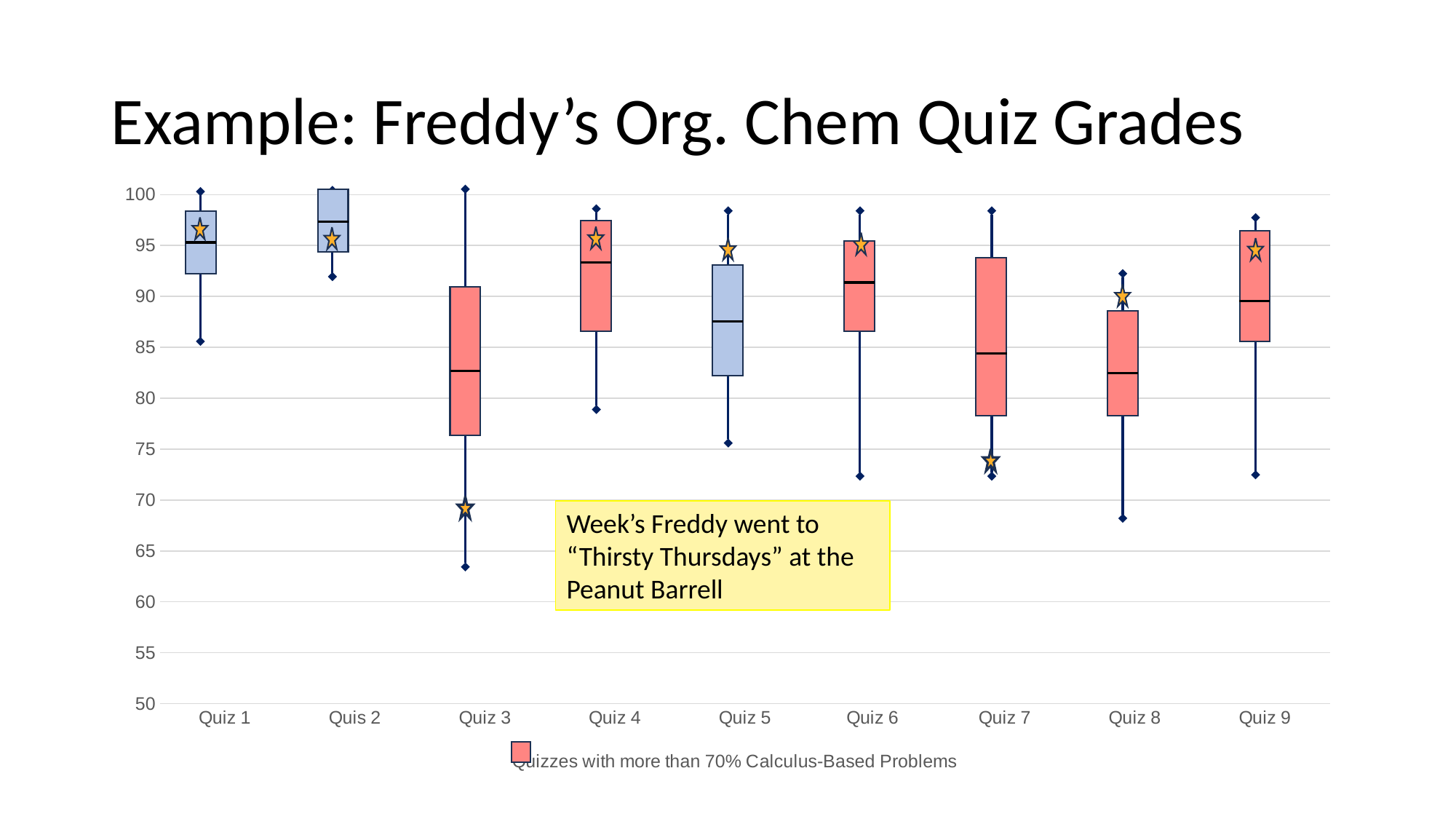
Which quiz has the lowest minimum (bottom whisker)? Quiz 3 What kind of chart is shown on the slide? Box-and-whisker chart Which quiz has the lowest star marker? Quiz 3 Which has the higher median line, Quiz 4 or Quiz 5? Quiz 4 How many series does the legend list? 1 How many quizzes are plotted along the x axis? 9 Is the bottom whisker for Quiz 8 greater or less than 70? less What is the legend entry for the red boxes? Quizzes with more than 70% Calculus-Based Problems Is the median line for Quiz 5 greater or less than 85? greater Is the bottom whisker for Quiz 3 greater or less than 65? less Which has the higher star marker, Quiz 7 or Quiz 8? Quiz 8 Which quiz has the highest median line? Quis 2